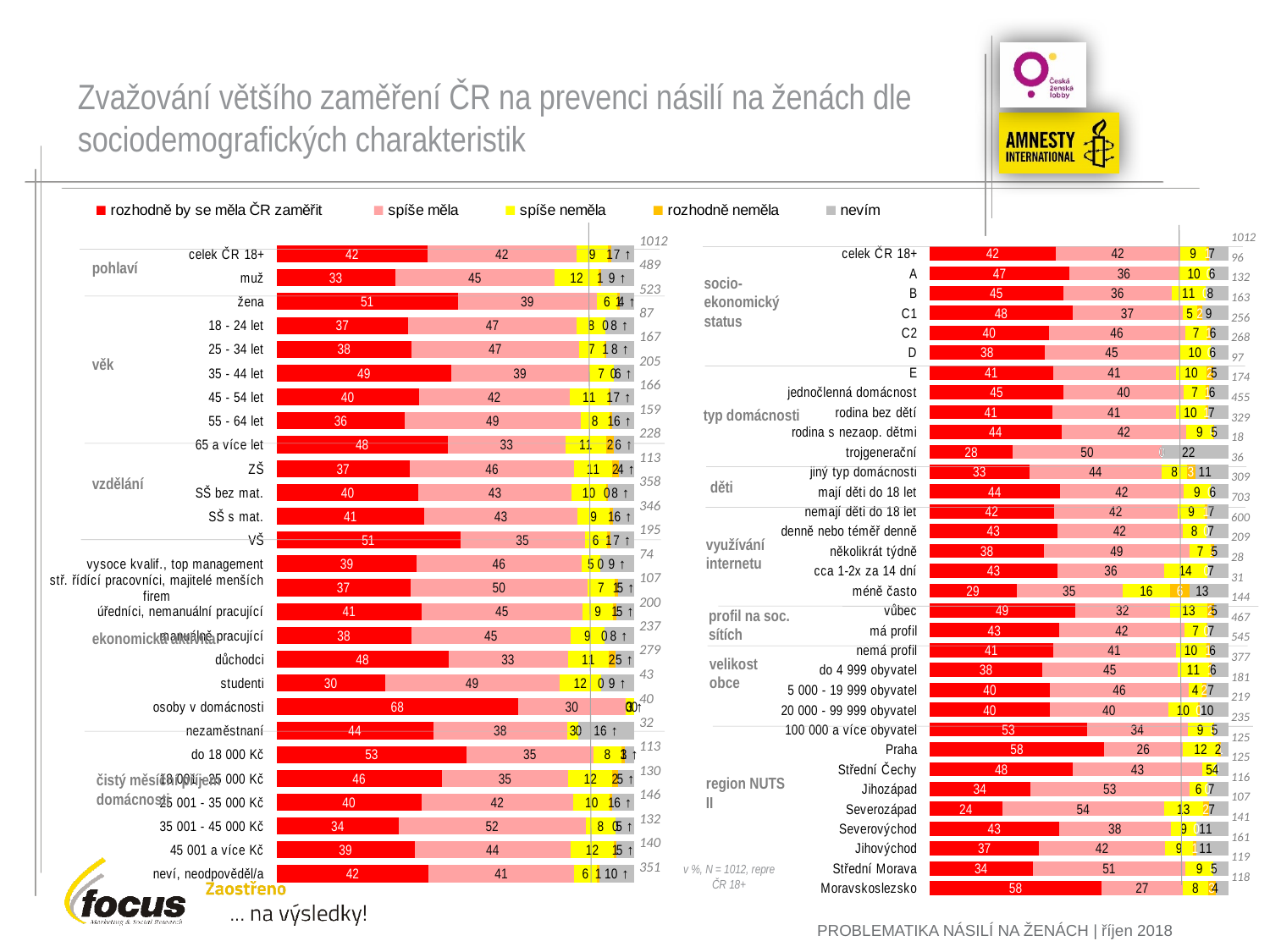
How many series does the legend at the top of the slide list? 5 In the left chart, what is the value of 'spíše měla' for 'muž'? 45 In the left chart, what is the difference between the 'rozhodně by se měla ČR zaměřit' values for 'žena' and 'muž'? 18 In the right chart, what is the value of 'spíše měla' for 'Jihozápad'? 53 What kind of chart is used on the left side of the slide? stacked bar chart In the left chart, which has a larger 'rozhodně by se měla ČR zaměřit' value: 'VŠ' or 'ZŠ'? VŠ In the left chart, what is the value of 'rozhodně by se měla ČR zaměřit' for 'žena'? 51 In the right chart, which has a larger 'spíše měla' value: 'Severozápad' or 'Moravskoslezsko'? Severozápad In the left chart, which category has the highest value for 'rozhodně by se měla ČR zaměřit'? osoby v domácnosti In the right chart, which region NUTS II category has the lowest value for 'rozhodně by se měla ČR zaměřit'? Severozápad In the right chart, what is the value of 'rozhodně by se měla ČR zaměřit' for 'Praha'? 58 In the right chart, what is the value of 'nevím' for 'trojgenerační'? 22